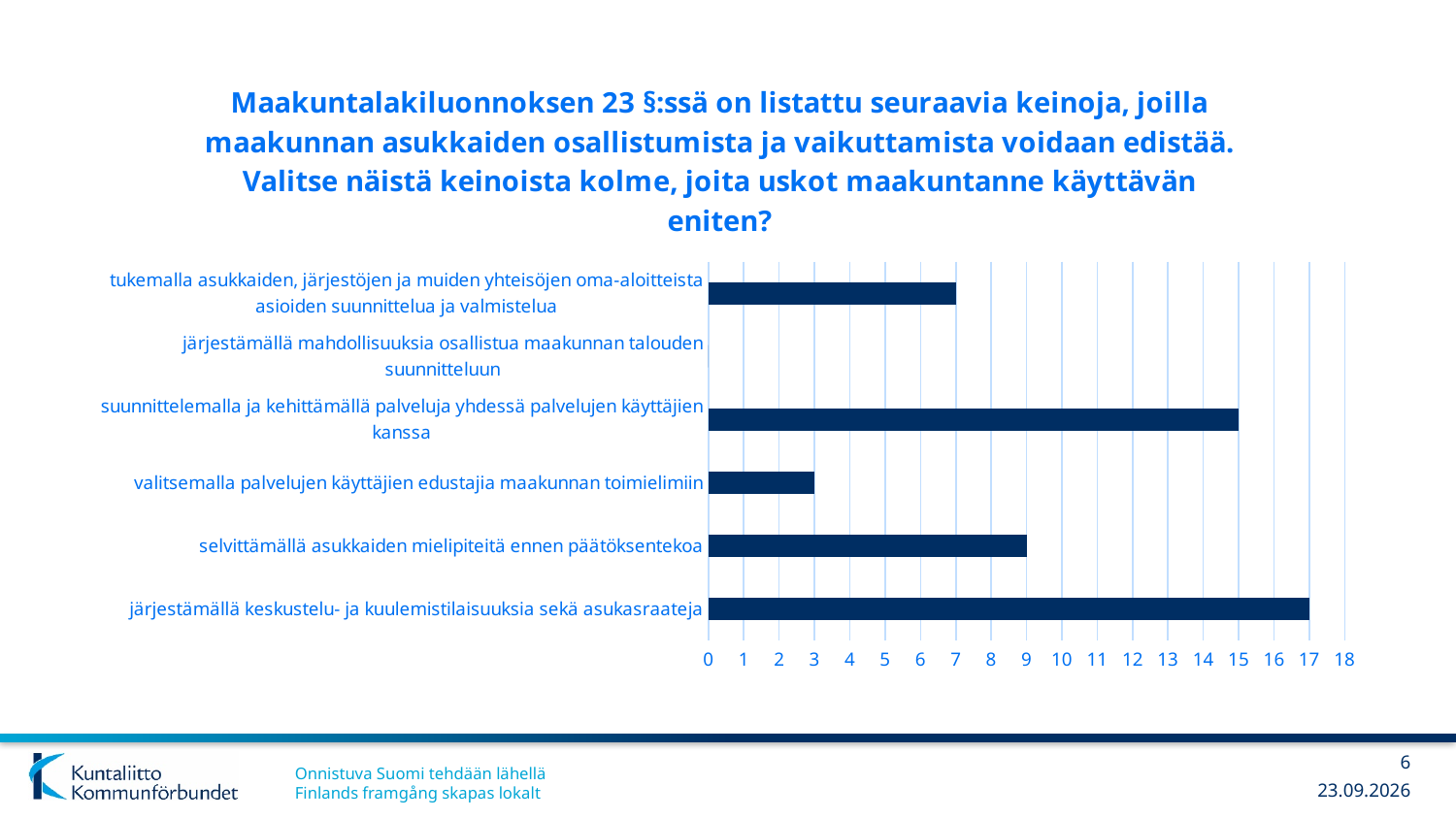
What is the value for 'valitsemalla palvelujen käyttäjien edustajia maakunnan toimielimiin'? 3 What is the value for 'tukemalla asukkaiden, järjestöjen ja muiden yhteisöjen oma-aloitteista asioiden suunnittelua ja valmistelua'? 7 Which is larger: the value for 'selvittämällä asukkaiden mielipiteitä ennen päätöksentekoa' or the value for 'valitsemalla palvelujen käyttäjien edustajia maakunnan toimielimiin'? selvittämällä asukkaiden mielipiteitä ennen päätöksentekoa How many categories are plotted in the chart? 6 What kind of chart is shown on the slide? bar chart What is the value for 'selvittämällä asukkaiden mielipiteitä ennen päätöksentekoa'? 9 Is the value for 'tukemalla asukkaiden, järjestöjen ja muiden yhteisöjen oma-aloitteista asioiden suunnittelua ja valmistelua' greater or less than 10? less Which category has the highest value? järjestämällä keskustelu- ja kuulemistilaisuuksia sekä asukasraateja What is the value for 'suunnittelemalla ja kehittämällä palveluja yhdessä palvelujen käyttäjien kanssa'? 15 Which category has the lowest value? järjestämällä mahdollisuuksia osallistua maakunnan talouden suunnitteluun What is the value for 'järjestämällä keskustelu- ja kuulemistilaisuuksia sekä asukasraateja'? 17 What is the difference between the values for 'järjestämällä keskustelu- ja kuulemistilaisuuksia sekä asukasraateja' and 'suunnittelemalla ja kehittämällä palveluja yhdessä palvelujen käyttäjien kanssa'? 2